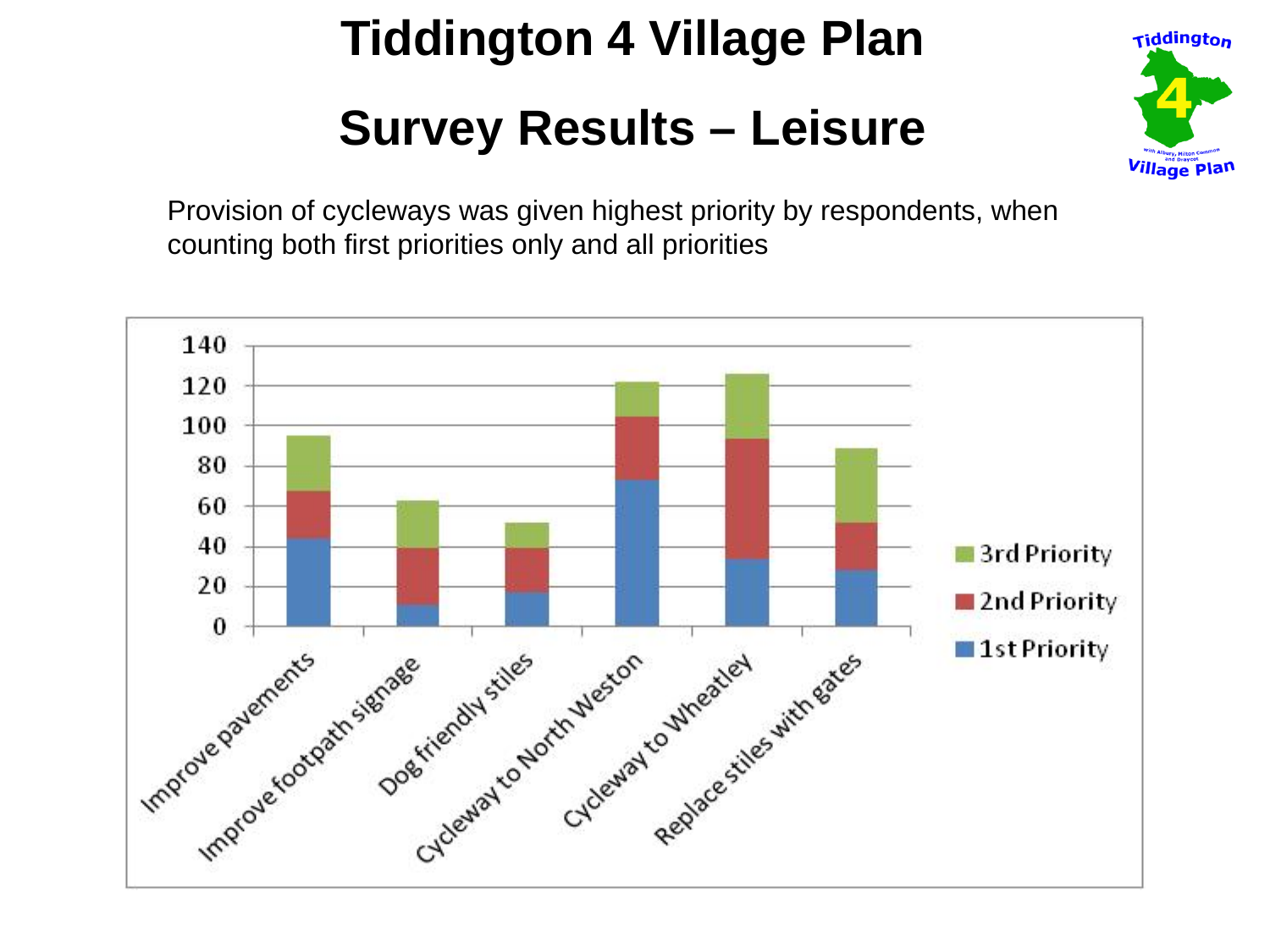
Which colour represents 1st Priority in the chart's legend? Blue Which has the larger total stacked bar, Improve pavements or Improve footpath signage? Improve pavements Is the total stacked value for Cycleway to North Weston greater or less than 100? greater Is the total stacked value for Replace stiles with gates greater or less than 100? less Is the total stacked value for Dog friendly stiles greater or less than 60? less How many categories are shown on the x axis of the chart? 6 Which category has the lowest total stacked bar? Dog friendly stiles Which category has the lowest 1st Priority value? Improve footpath signage Which has the larger 1st Priority value, Cycleway to North Weston or Cycleway to Wheatley? Cycleway to North Weston How many series does the chart's legend list? 3 What kind of chart is shown on the slide? Stacked bar chart Which category has the highest 1st Priority value? Cycleway to North Weston